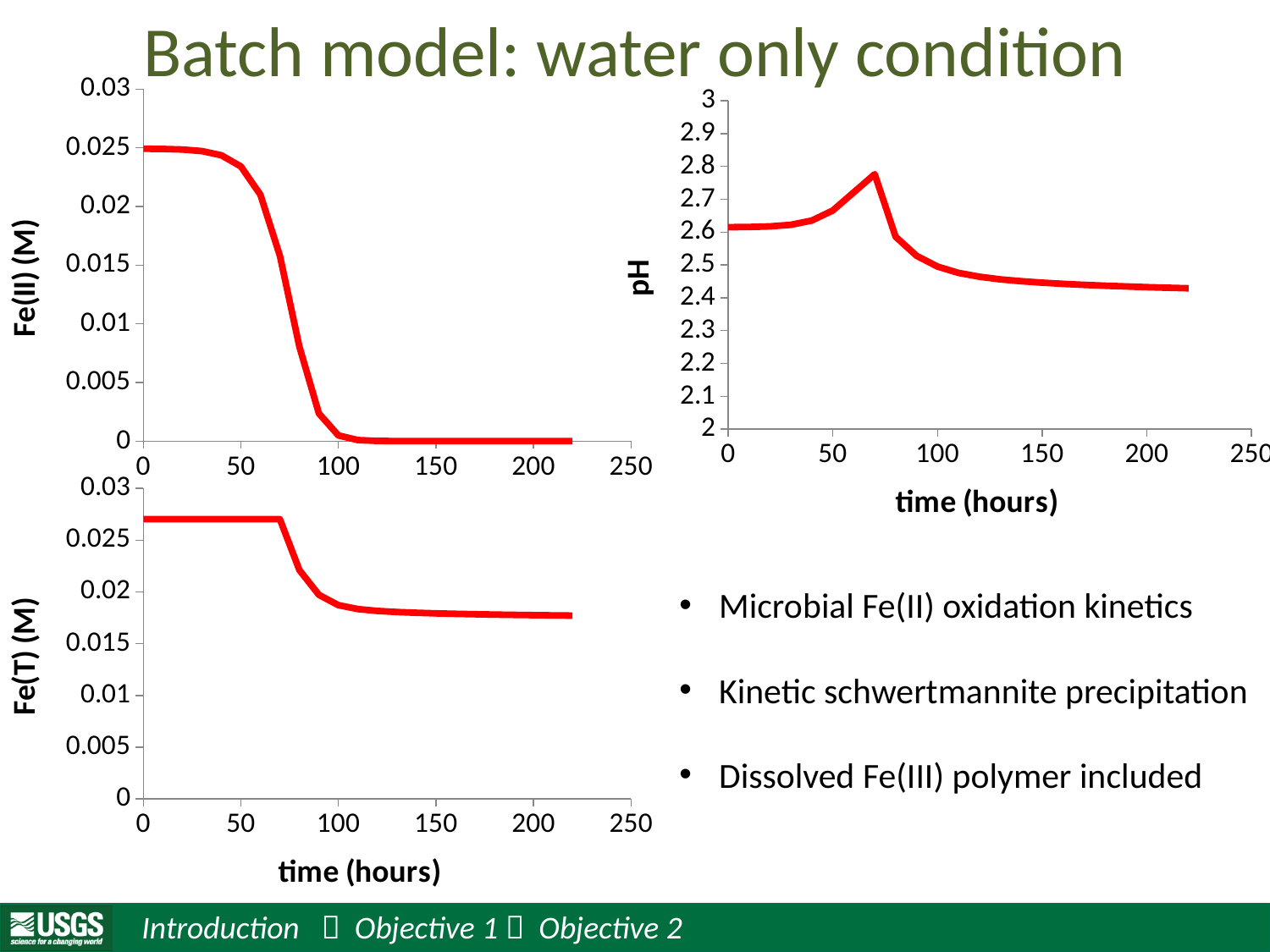
How many charts are shown on the slide? 3 What kind of chart is the top-left chart showing Fe(II) (M) against time? line chart In the top-right pH chart, is the peak pH value greater or less than 2.7? greater What is the x-axis label of the top-right pH chart? time (hours) In the top-right pH chart, is the pH at 220 hours higher or lower than the pH at 0 hours? lower In the bottom-left Fe(T) chart, is the Fe(T) value at 200 hours greater or less than 0.02? less In the bottom-left Fe(T) chart, is the Fe(T) value at 0 hours greater or less than 0.025? greater In the top-left Fe(II) chart, does the Fe(II) concentration rise or fall as time increases? fall In the bottom-left Fe(T) chart, does the Fe(T) concentration rise or fall over time? fall